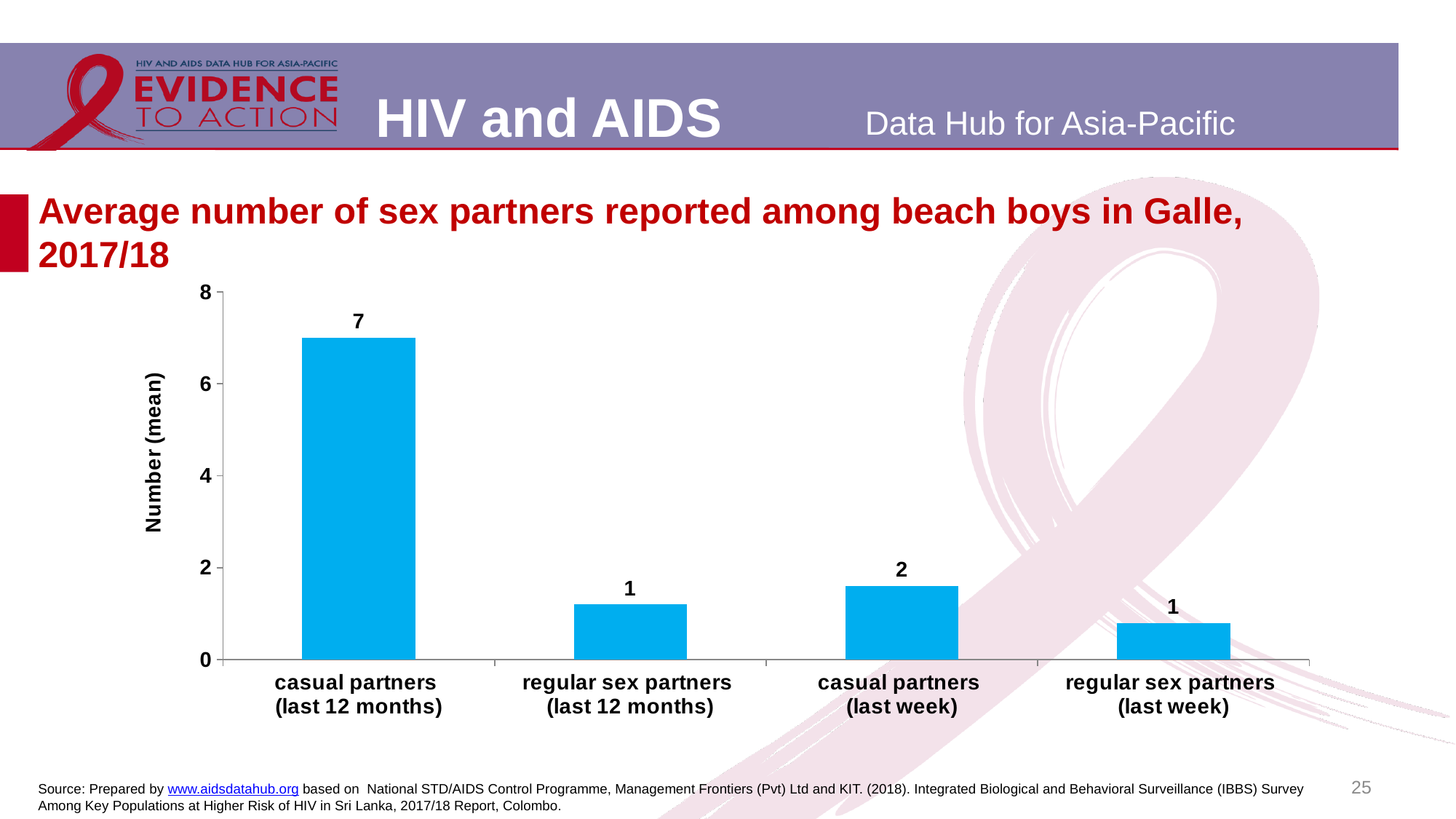
Is the value for regular sex partners (last 12 months) greater or less than 2? less Is the value for casual partners (last 12 months) greater or less than 6? greater Which category has the highest average number of sex partners? casual partners (last 12 months) What kind of chart is shown on the slide? bar chart Which is larger: the average number of casual partners (last week) or regular sex partners (last week)? casual partners (last week) What is the average number of regular sex partners (last 12 months) shown on the chart? 1 How many categories are shown on the chart? 4 What is the difference between the average number of casual partners (last 12 months) and regular sex partners (last 12 months)? 6 What is the label of the vertical axis of the chart? Number (mean) What is the average number of casual partners (last week) shown on the chart? 2 What is the average number of regular sex partners (last week) shown on the chart? 1 What is the average number of casual partners (last 12 months) reported among beach boys in Galle? 7